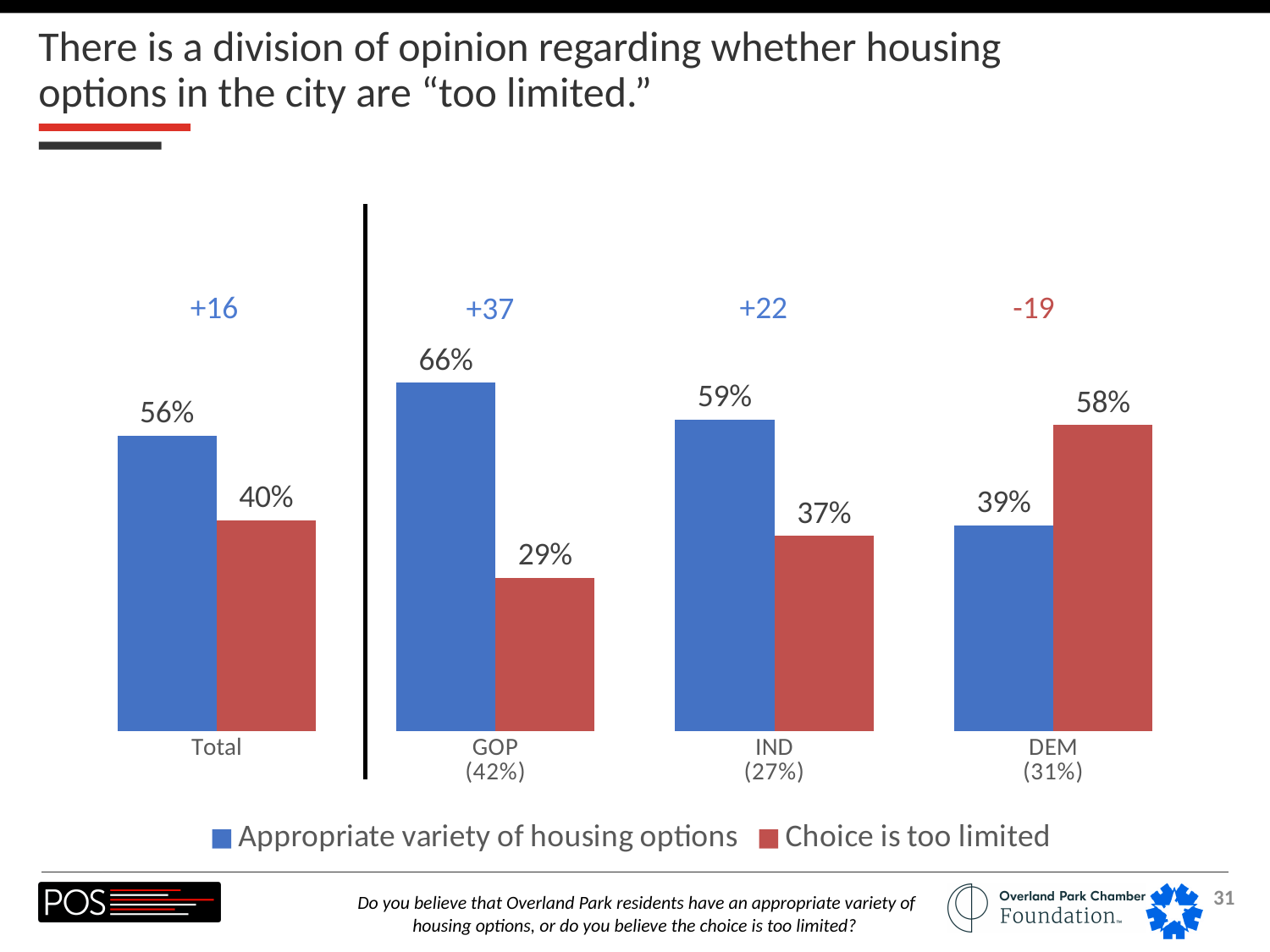
What net figure is shown above the DEM bars? -19 What percentage of the Total group says there is an appropriate variety of housing options? 56% How many series does the legend list? 2 For DEM, which is larger: 'Appropriate variety of housing options' or 'Choice is too limited'? Choice is too limited What kind of chart is shown on the slide? Bar chart Which group has the highest value for 'Appropriate variety of housing options'? GOP How many groups are shown on the x axis? 4 Which group has the lowest value for 'Choice is too limited'? GOP What percentage of DEM respondents say the choice is too limited? 58% What colour represents 'Choice is too limited' in the legend? Red What is the difference between the 'Appropriate variety' and 'Choice is too limited' values for IND? 22 What percentage of GOP respondents say the choice is too limited? 29%